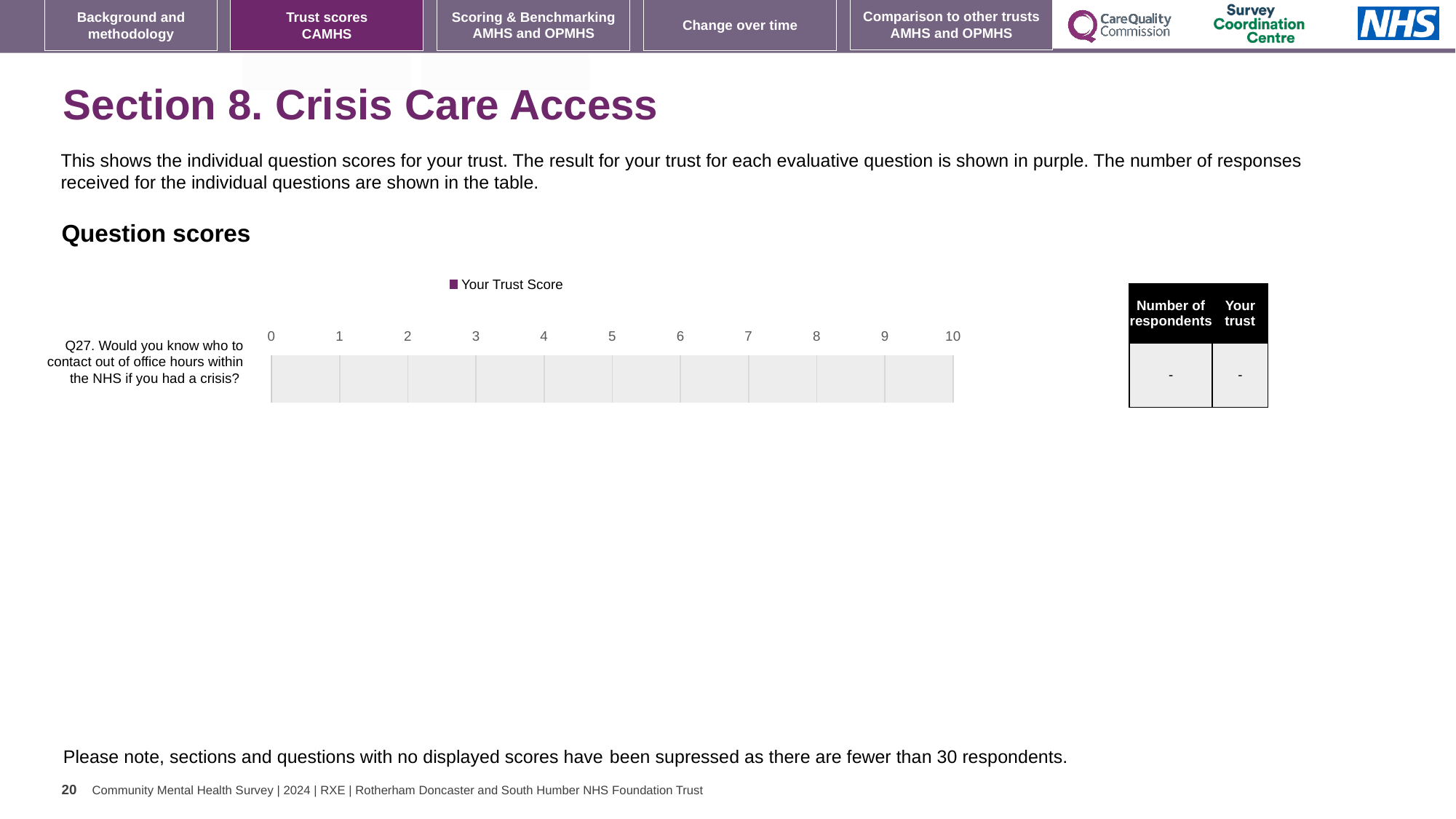
What is the highest value shown on the chart's horizontal axis? 10 What is the name of the series shown in the chart legend? Your Trust Score What kind of chart is shown under 'Question scores'? bar chart What value does the table show for 'Your trust' for Q27? - Is a bar plotted for Q27 on the chart? No How many questions (categories) are listed on the chart's vertical axis? 1 How many series does the chart legend list? 1 What value does the table show for 'Number of respondents' for Q27? -